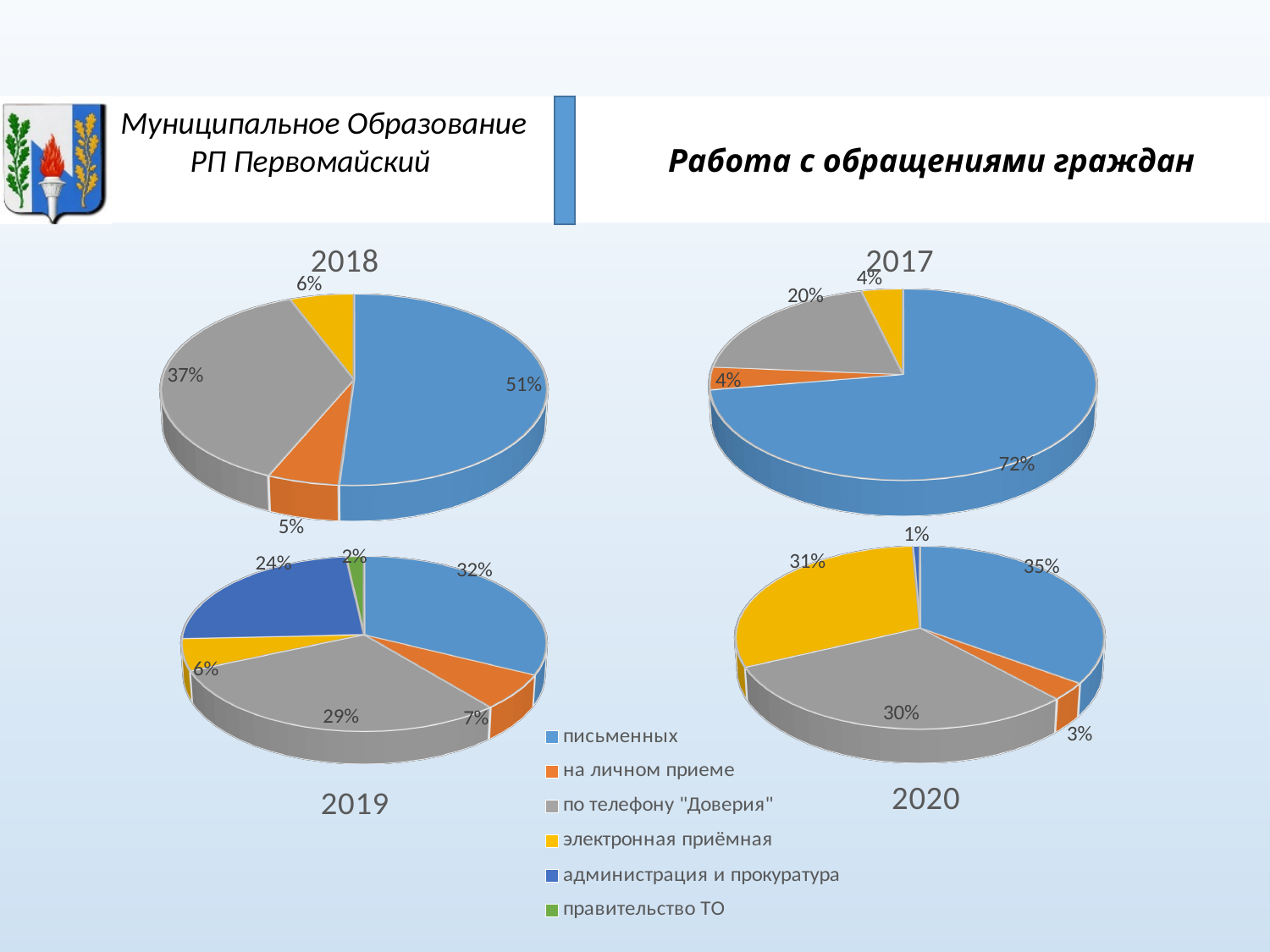
In the 2019 pie chart, which category has the smallest share? правительство ТО In the 2019 pie chart, what share is shown for администрация и прокуратура? 24% In the 2017 pie chart, which category has the largest share? письменных In the 2018 pie chart, what is the difference between the shares for письменных and по телефону "Доверия"? 14% How many slices does the 2019 pie chart have? 6 In the 2020 pie chart, what share is shown for электронная приёмная? 31% In the 2017 pie chart, what share is shown for по телефону "Доверия"? 20% In the 2018 pie chart, what share is shown for письменных? 51% What kind of chart is used for the 2017 data? pie chart How many entries does the legend list? 6 Which colour represents на личном приеме in the legend? orange In the 2020 pie chart, which is larger: the share for письменных or the share for по телефону "Доверия"? письменных